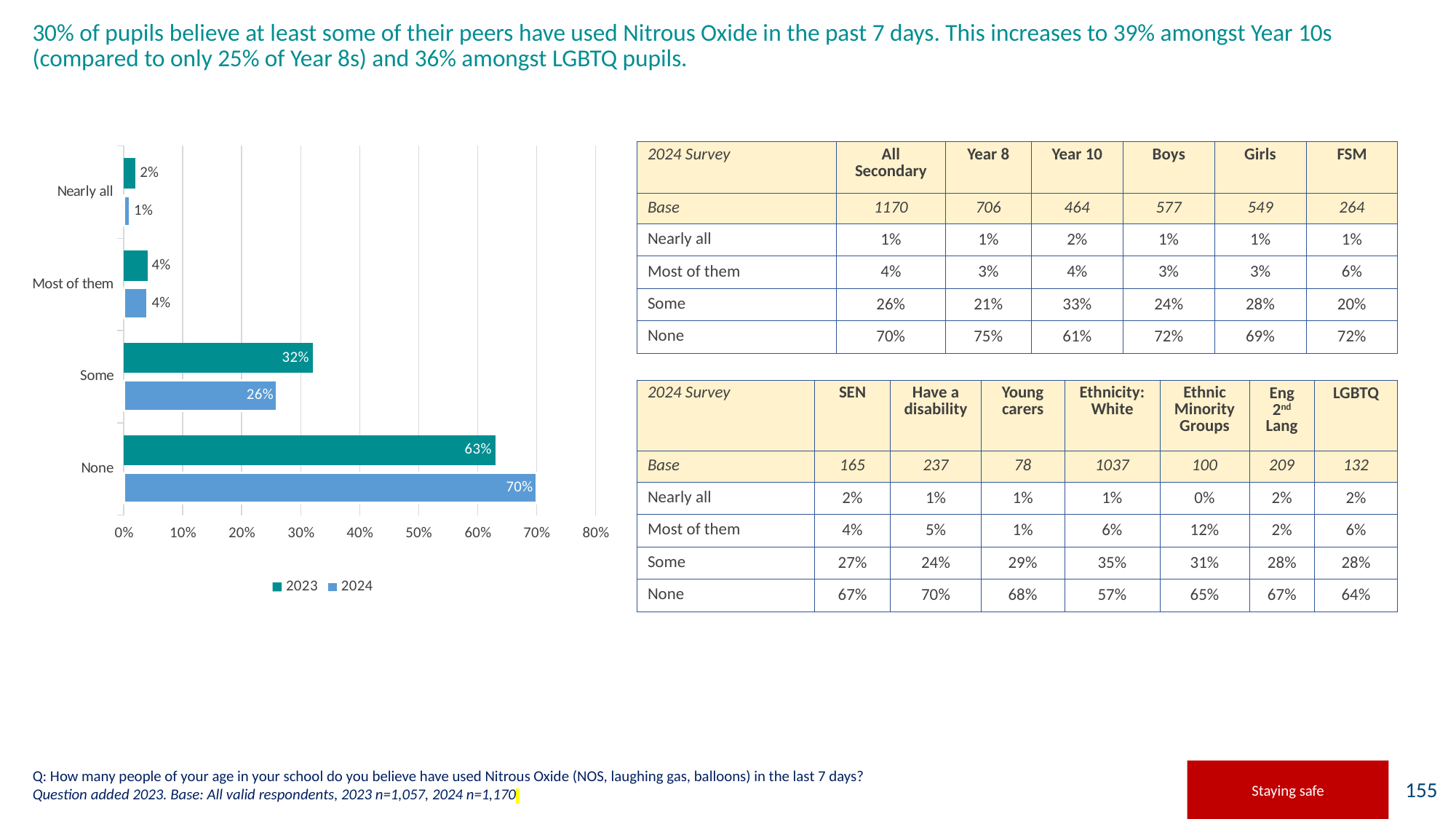
What is the 2024 value for 'None' in the bar chart? 70% What is the 2024 value for 'Most of them' in the bar chart? 4% What is the difference between the 2024 and 2023 values for 'None' in the bar chart? 7% Which category has the highest 2024 value in the bar chart? None In the bar chart, is the 2023 value for 'Some' larger or the 2024 value for 'Some'? 2023 How many categories are shown in the bar chart? 4 Which category has the lowest 2023 value in the bar chart? Nearly all What is the 2023 value for 'Some' in the bar chart? 32% What is the difference between the 2023 and 2024 values for 'Some' in the bar chart? 6% What kind of chart is shown on the slide? Bar chart What is the 2023 value for 'Nearly all' in the bar chart? 2% How many series does the legend of the bar chart list? 2